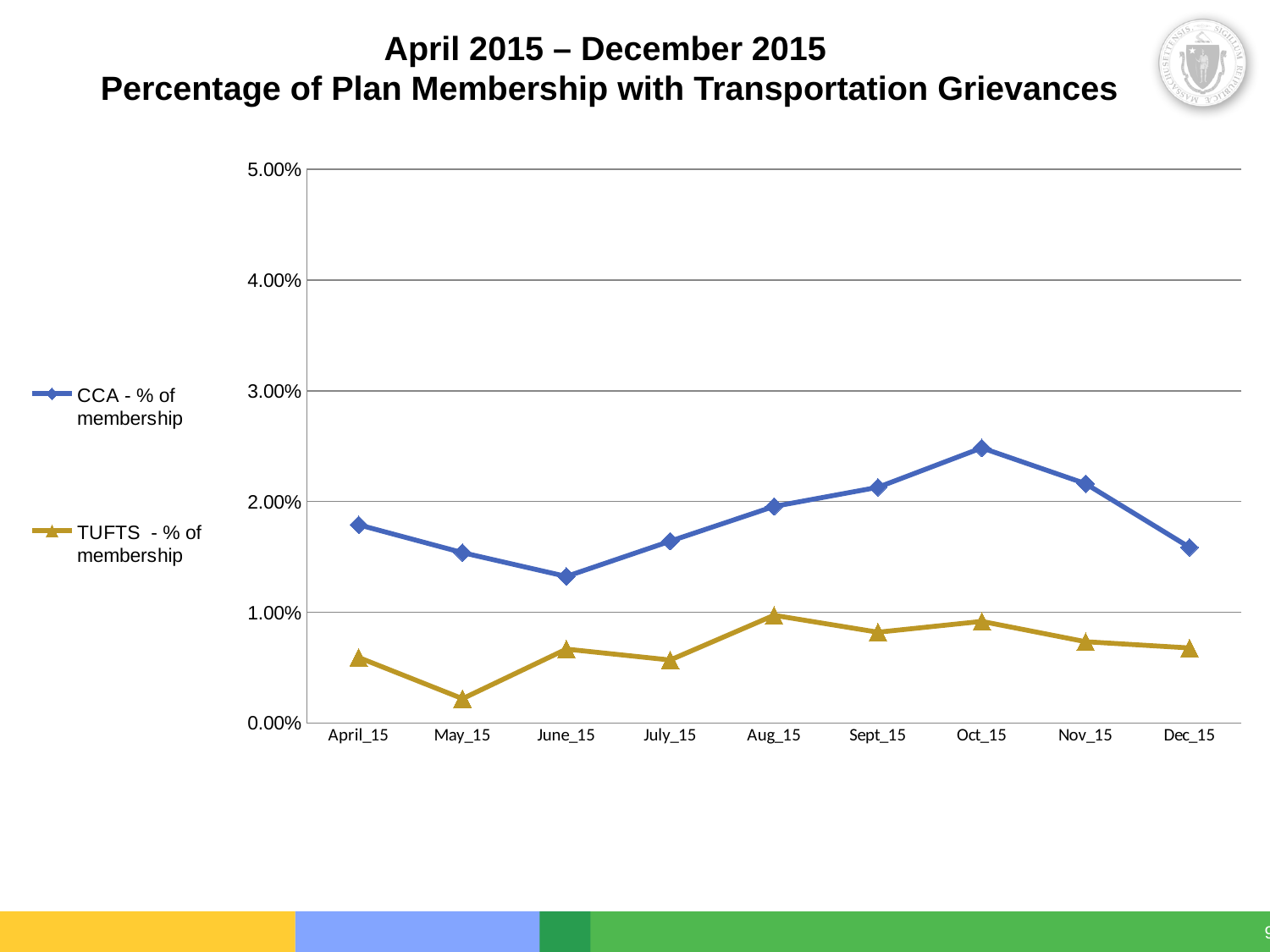
In Oct_15, which series has the larger value, CCA - % of membership or TUFTS - % of membership? CCA - % of membership In which month is the CCA - % of membership value highest? Oct_15 Does the CCA - % of membership line rise or fall from June_15 to Oct_15? rise What colour is the CCA - % of membership line? blue Is the CCA - % of membership value for Oct_15 greater or less than 2.00%? greater In which month is the TUFTS - % of membership value lowest? May_15 Is the CCA - % of membership value for April_15 greater or less than 2.00%? less What kind of chart is shown on the slide? line chart How many series does the legend list? 2 In which month is the CCA - % of membership value lowest? June_15 How many months are plotted along the x axis? 9 Is the TUFTS - % of membership value for May_15 greater or less than 1.00%? less